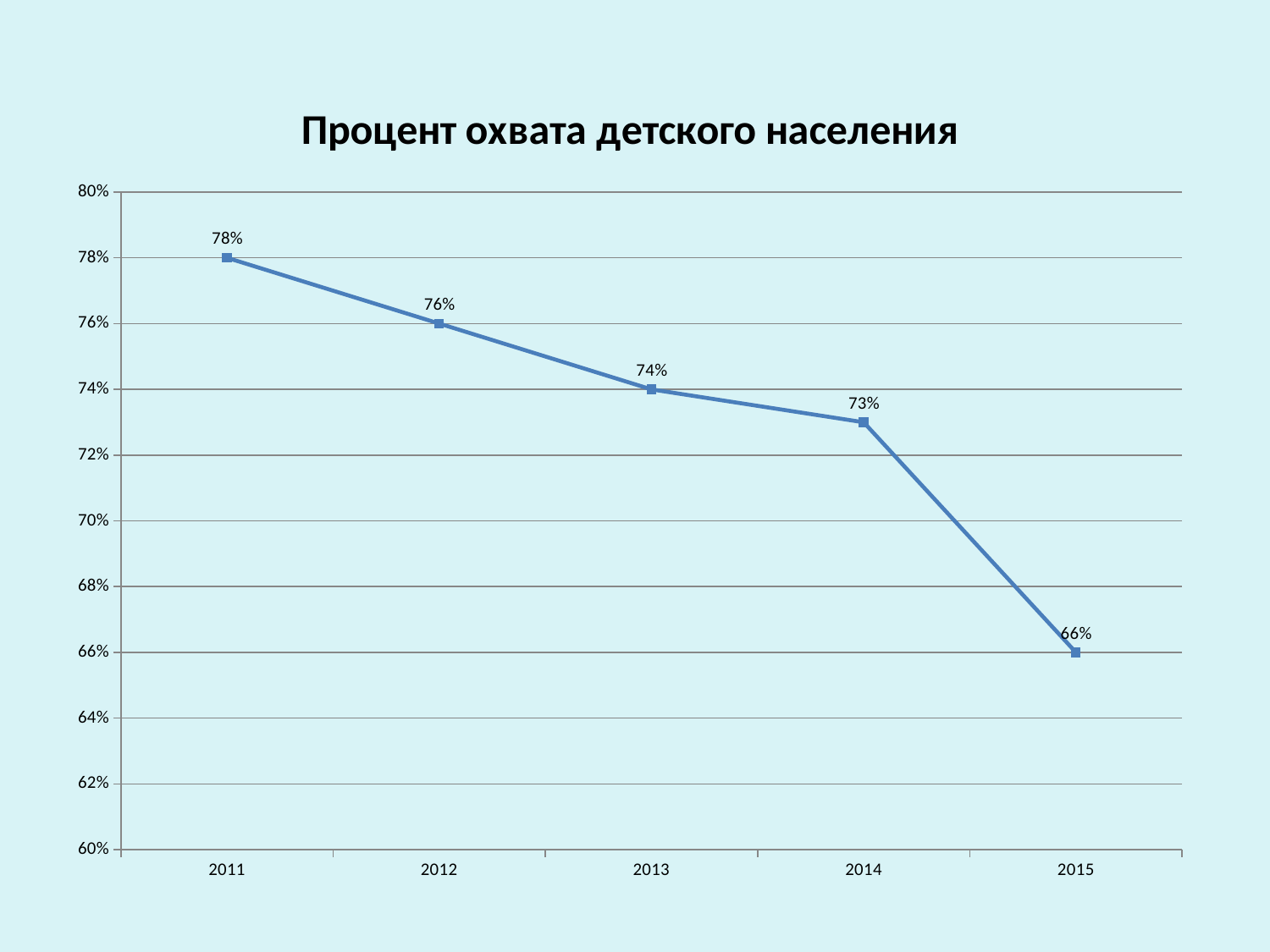
What is the difference between the values for 2011 and 2012? 2% What is the value for 2015? 66% Is the value for 2015 greater or less than 70%? less What kind of chart is shown? line chart Which year has the lowest value? 2015 What is the value for 2013? 74% Which year has the highest value? 2011 Which is larger, the value for 2012 or the value for 2014? 2012 Do the values rise or fall from 2011 to 2015? fall How many years are plotted on the chart? 5 What is the difference between the values for 2014 and 2015? 7% What is the value for 2011? 78%